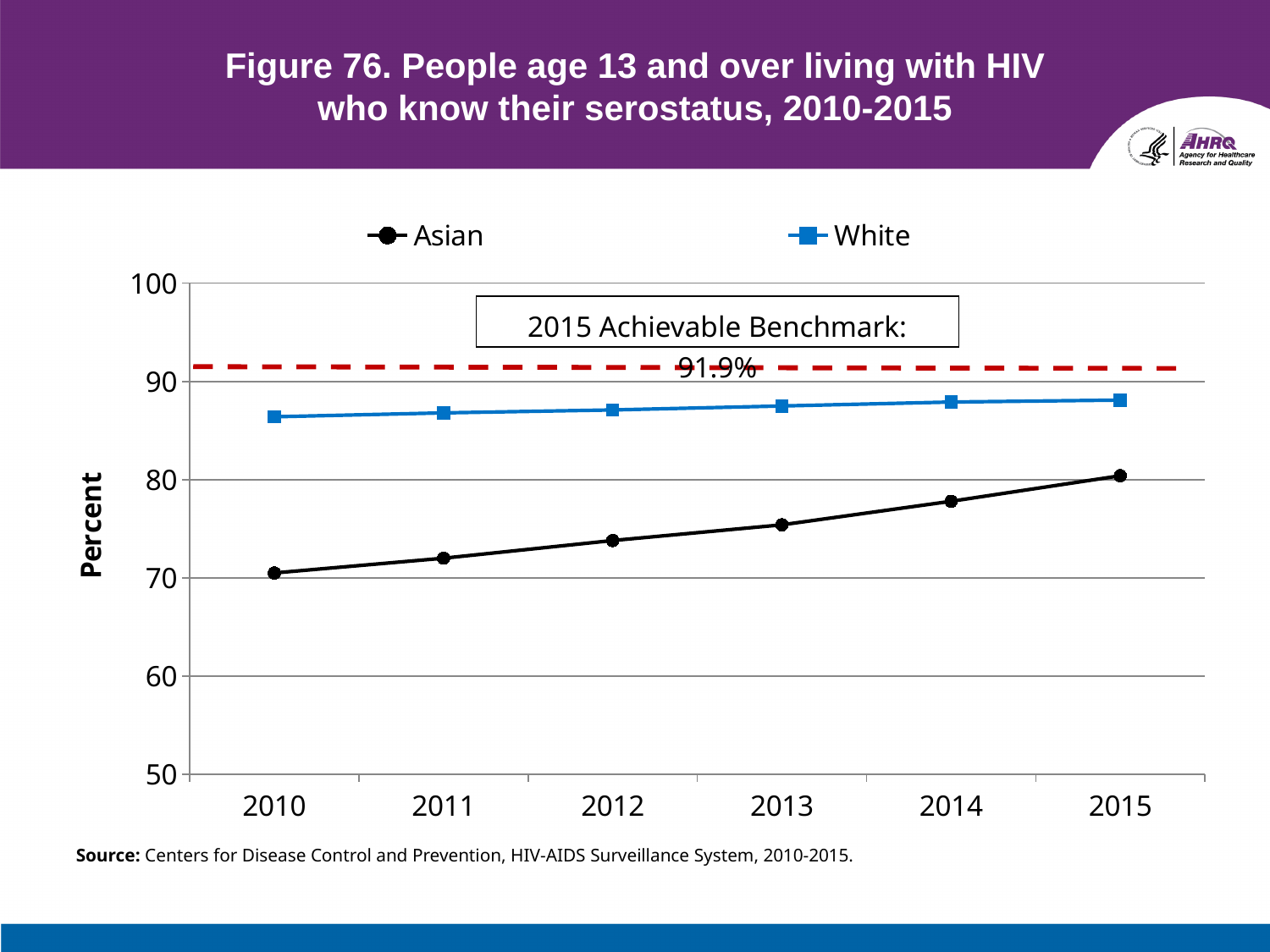
How many years are plotted along the x axis? 6 In 2015, which group has the higher value, Asian or White? White Is the value for White in 2015 greater or less than 90? less Does the Asian series rise or fall from 2010 to 2015? rise In which year is the Asian series at its lowest? 2010 What is the 2015 Achievable Benchmark value shown on the chart? 91.9% In which year is the Asian series at its highest? 2015 How many series does the legend list? 2 What is the label on the y axis? Percent Is the value for Asian in 2013 greater or less than 80? less What kind of chart is shown on the slide? line chart Does the White series rise or fall from 2010 to 2015? rise